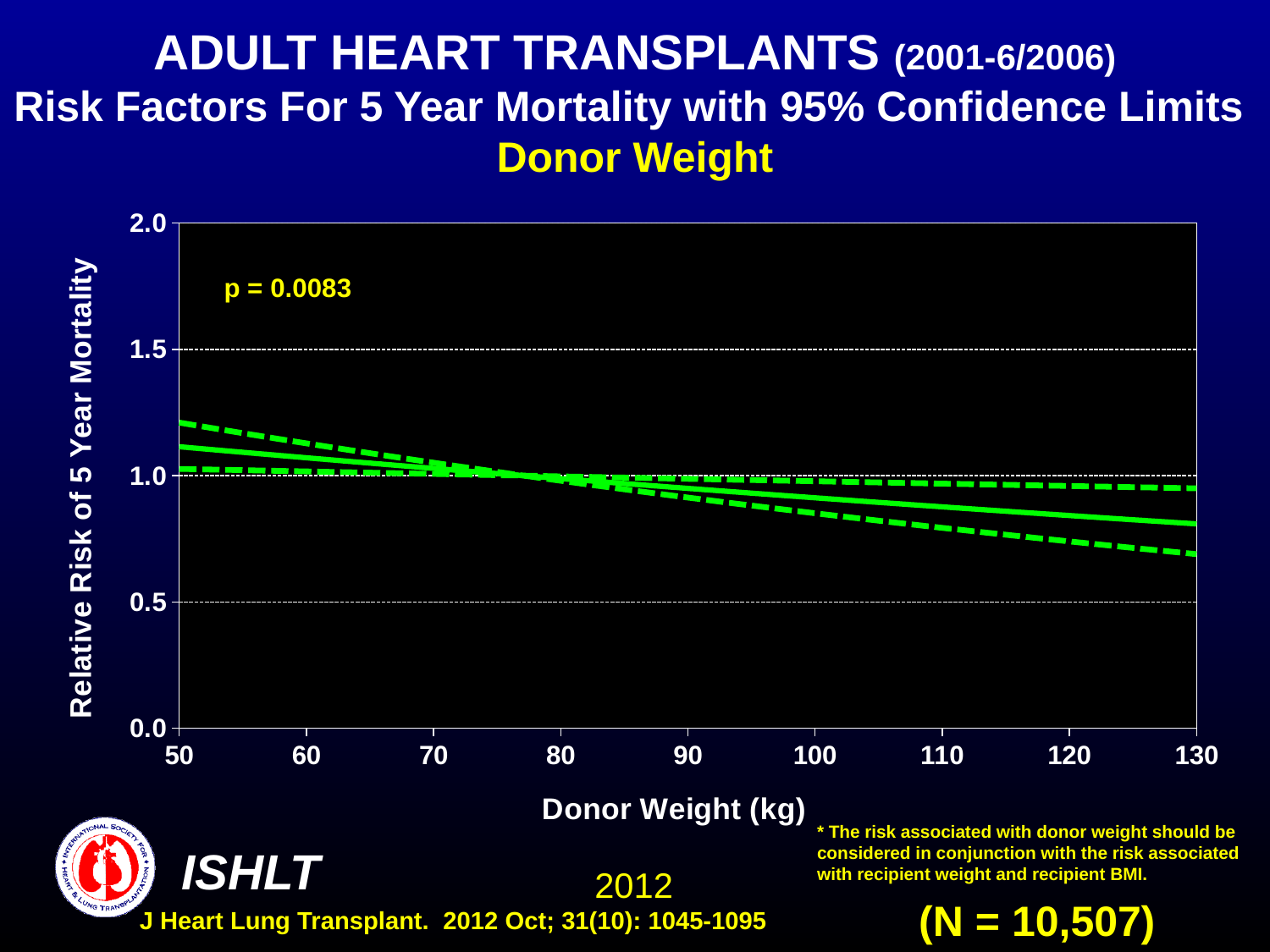
Is the lower 95% confidence limit at a donor weight of 130 kg greater or less than 0.5? greater What is the highest value labelled on the y axis? 2.0 Does the relative risk of 5 year mortality rise or fall as donor weight increases from 50 to 130 kg? fall Is the relative risk (solid line) larger at a donor weight of 50 kg or at 130 kg? 50 kg Is the relative risk (solid line) at a donor weight of 50 kg greater or less than 1.0? greater Is the upper 95% confidence limit at a donor weight of 50 kg greater or less than 1.5? less How many lines are plotted on the chart? 3 How many tick labels are shown on the x axis? 9 What kind of chart is shown on the slide? line chart What p-value is shown on the chart? p = 0.0083 What is the sample size (N) shown on the slide? N = 10,507